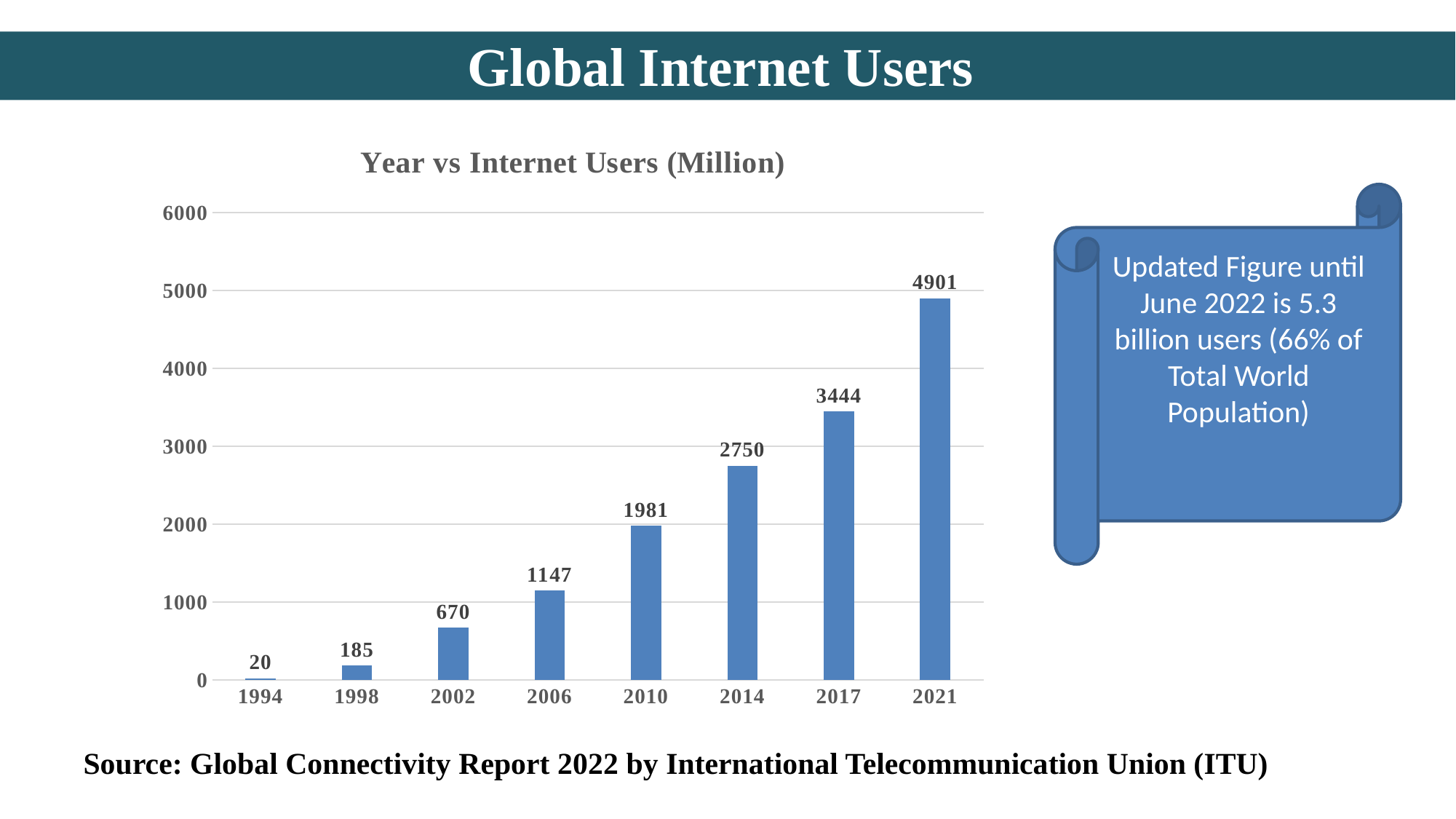
What is the difference between the values for 2006 and 2002? 477 Which year has the lowest value in the chart? 1994 What kind of chart is shown on the slide? bar chart What is the value for 2017 in the chart? 3444 What is the value for 2010 in the chart? 1981 What is the value for 1998 in the chart? 185 Which is larger, the value for 2014 or the value for 2010? 2014 How many years are shown on the x axis of the chart? 8 What is the difference between the values for 2021 and 2017? 1457 Which year has the highest value in the chart? 2021 Do the values rise or fall from 1994 to 2021? rise Is the value for 2014 greater or less than 3000? less